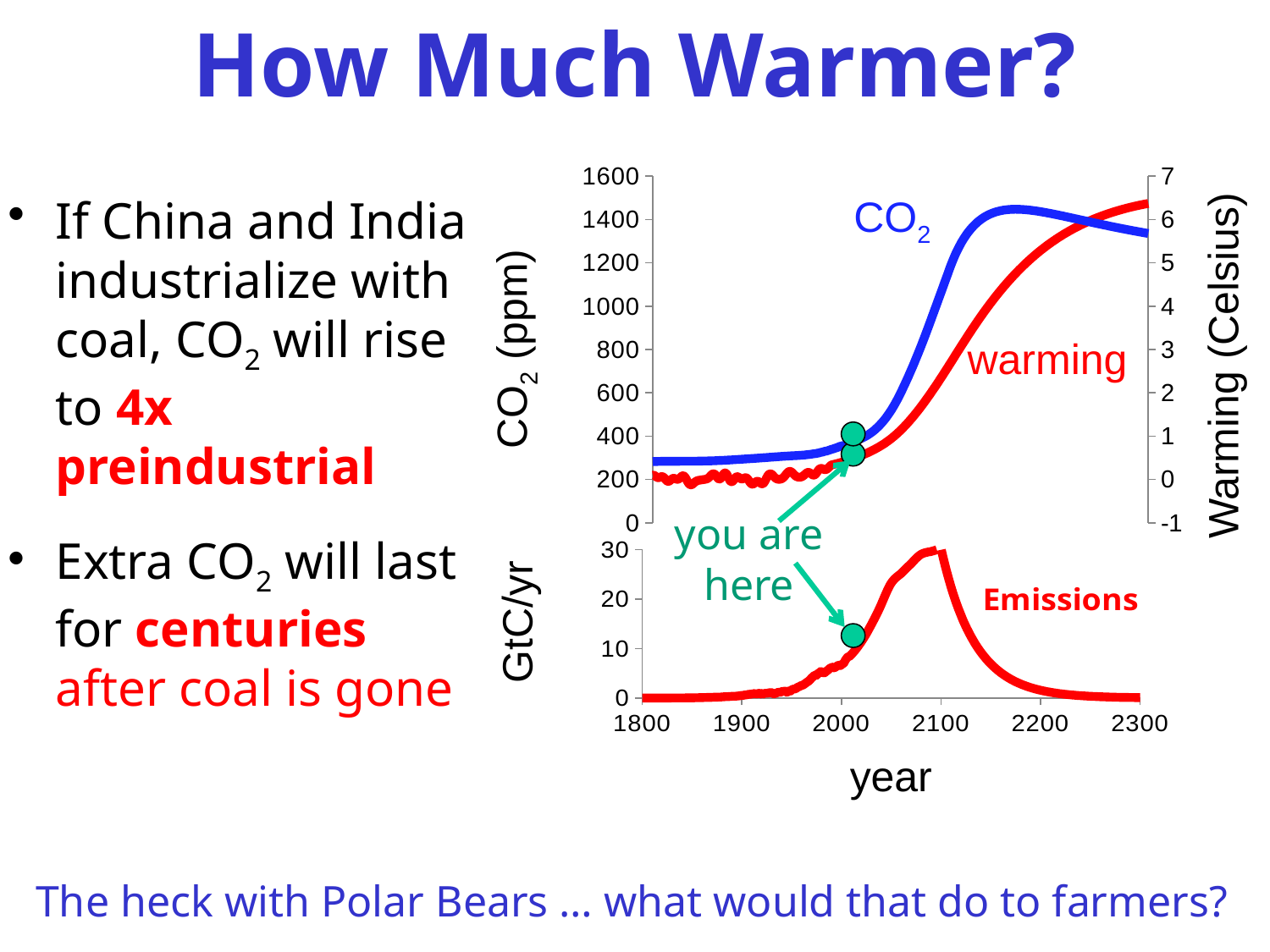
In the upper chart, is the warming value in 2300 greater or less than 5 degrees Celsius? greater In the lower Emissions chart, is the peak emissions value (around 2100) greater or less than 20 GtC/yr? greater In the upper chart, does the CO2 line rise or fall between 1800 and 2100? rise In the upper chart, how many data series are plotted? 2 In the lower Emissions chart, do emissions rise or fall between 2100 and 2200? fall What is the label on the right-hand vertical axis of the upper chart? Warming (Celsius) In the lower Emissions chart, which year has higher emissions, 2000 or 2100? 2100 In the upper chart, does the CO2 line rise or fall between 2200 and 2300? fall In the lower Emissions chart, is the emissions value in 2300 greater or less than 10 GtC/yr? less What kind of chart is the upper chart showing CO2 and warming? line chart